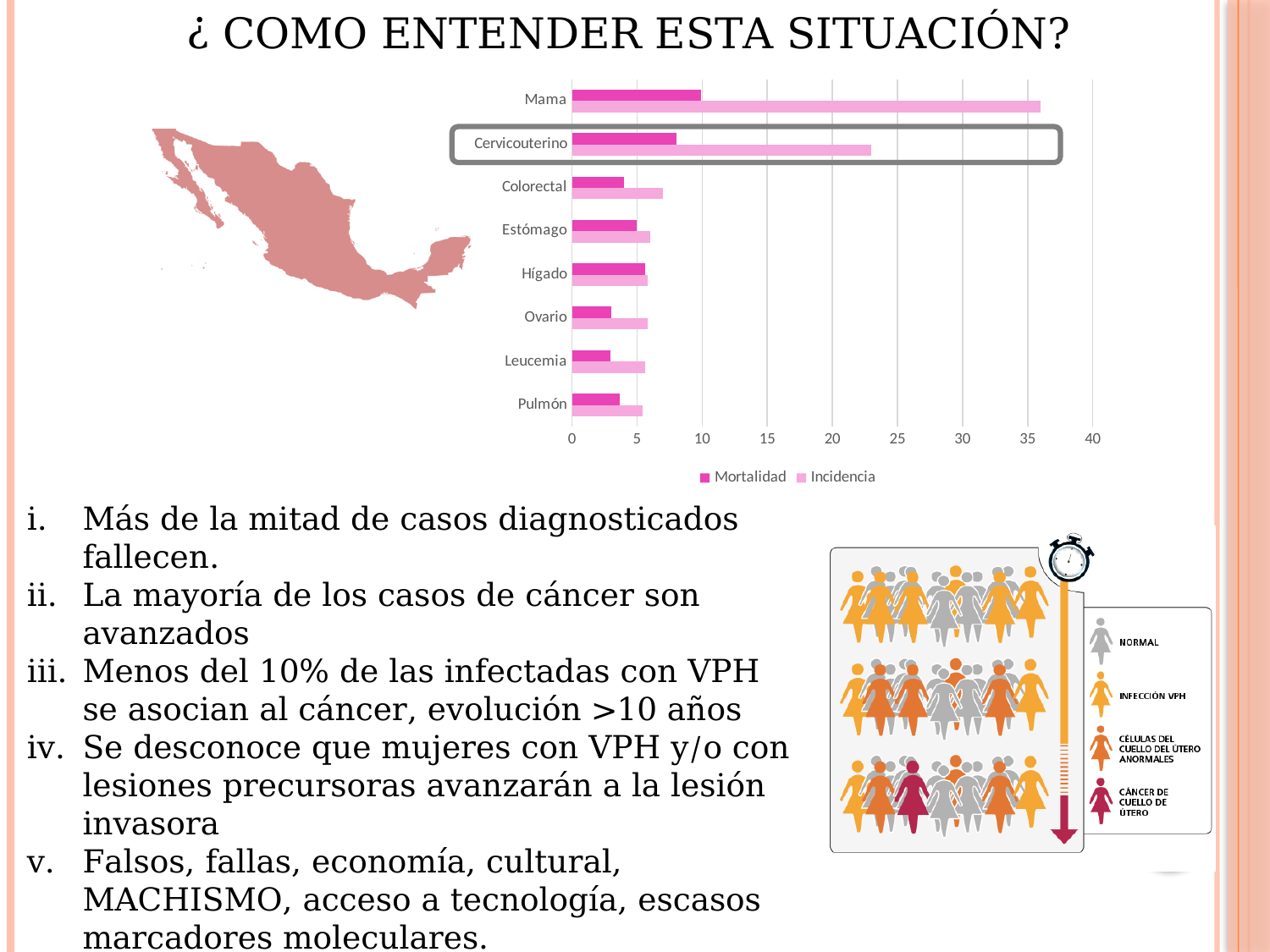
Is the Mortalidad value for Cervicouterino greater or less than 10? less How many cancer types (categories) are listed on the chart? 8 How many series does the chart legend list? 2 What kind of chart is shown on the slide? bar chart Which category has the highest Incidencia value? Mama For Ovario, which is larger, the Mortalidad value or the Incidencia value? Incidencia Is the Incidencia value for Mama greater or less than 30? greater Is the Incidencia value for Cervicouterino greater or less than 20? greater What are the two series named in the chart legend? Mortalidad and Incidencia Which category has the highest Mortalidad value? Mama Which category on the chart is highlighted with a grey box? Cervicouterino Which has a larger Incidencia value, Mama or Cervicouterino? Mama